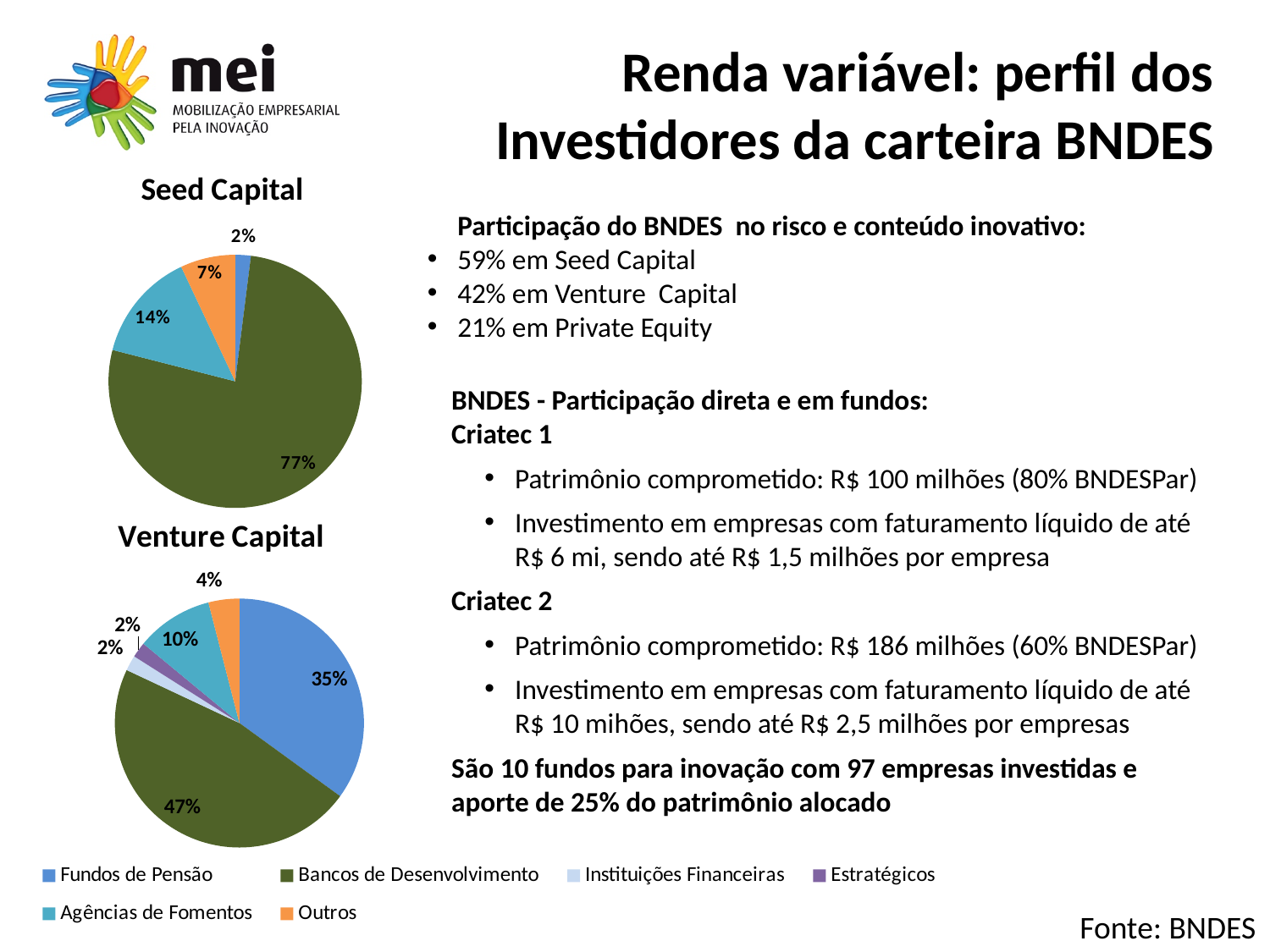
How many slices does the Seed Capital pie chart have? 4 In the Venture Capital chart, which is larger: Agências de Fomentos or Outros? Agências de Fomentos In the Seed Capital chart, what share do Agências de Fomentos hold? 14% In the Seed Capital chart, which category has the largest slice? Bancos de Desenvolvimento In the Venture Capital chart, which category has the largest slice? Bancos de Desenvolvimento What kind of chart is the Seed Capital chart? Pie chart In the Seed Capital chart, which category has the smallest slice? Fundos de Pensão How many slices does the Venture Capital pie chart have? 6 In the Venture Capital chart, what is the difference between the Bancos de Desenvolvimento share and the Fundos de Pensão share? 12% In the Seed Capital chart, what share do Bancos de Desenvolvimento hold? 77% In the Venture Capital chart, what share do Fundos de Pensão hold? 35% How many categories does the shared legend list? 6